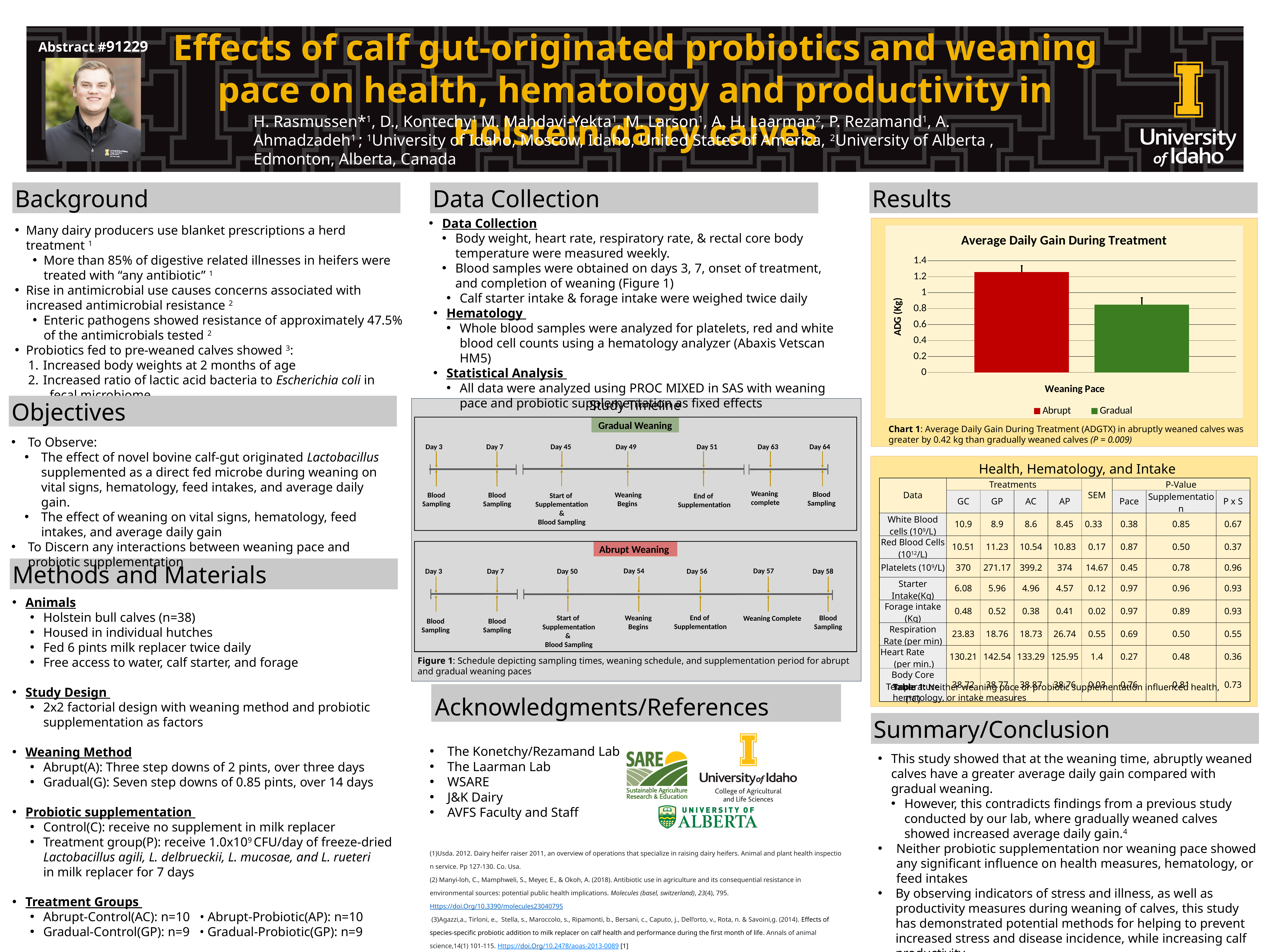
What colour is the Abrupt bar in the "Average Daily Gain During Treatment" chart? red What kind of chart is "Average Daily Gain During Treatment"? bar chart In the "Average Daily Gain During Treatment" chart, is the value for Abrupt greater or less than 1? greater How many series does the legend of the "Average Daily Gain During Treatment" chart list? 2 In the "Average Daily Gain During Treatment" chart, is the value for Abrupt greater or less than 1.4? less In the "Average Daily Gain During Treatment" chart, which weaning pace has the highest ADG? Abrupt In the "Average Daily Gain During Treatment" chart, which weaning pace has the lowest ADG? Gradual What is the label on the y axis of the "Average Daily Gain During Treatment" chart? ADG (Kg) In the "Average Daily Gain During Treatment" chart, which is larger, the ADG for Abrupt or for Gradual? Abrupt How many bars are plotted in the "Average Daily Gain During Treatment" chart? 2 In the "Average Daily Gain During Treatment" chart, is the value for Gradual greater or less than 0.6? greater